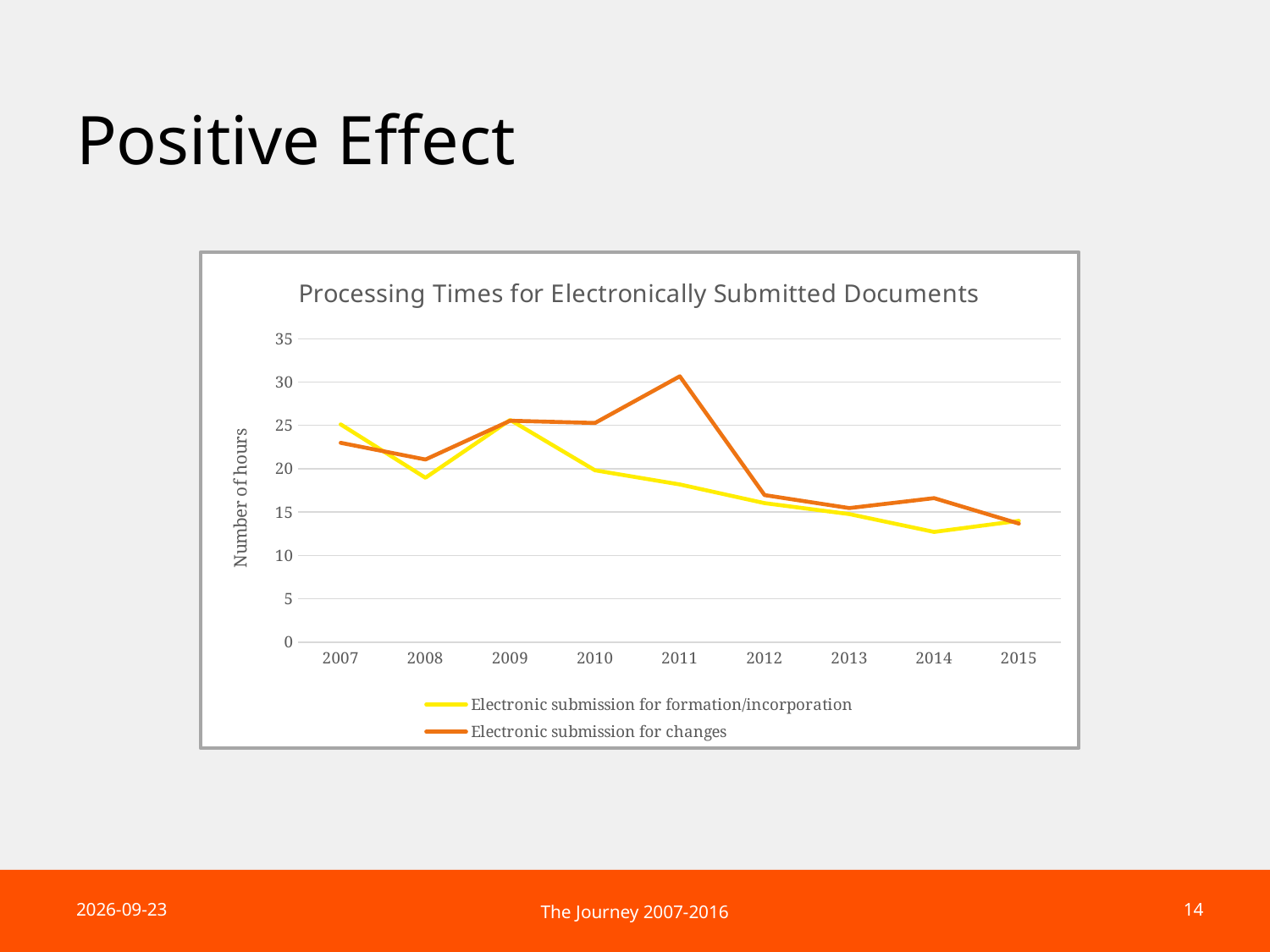
How many series does the legend list? 2 In which year does the 'Electronic submission for formation/incorporation' series reach its lowest value? 2014 What is the title of the chart? Processing Times for Electronically Submitted Documents In 2011, which series has the larger value: 'Electronic submission for changes' or 'Electronic submission for formation/incorporation'? Electronic submission for changes What kind of chart is shown on the slide? Line chart What is the label on the vertical axis of the chart? Number of hours Is the value for 'Electronic submission for formation/incorporation' in 2008 greater or less than 20? less How many years are plotted along the x axis? 9 Overall, do the values for 'Electronic submission for formation/incorporation' rise or fall from 2007 to 2015? Fall In which year does the 'Electronic submission for changes' series reach its highest value? 2011 Is the value for 'Electronic submission for changes' in 2011 greater or less than 30? greater Is the value for 'Electronic submission for formation/incorporation' in 2014 greater or less than 15? less